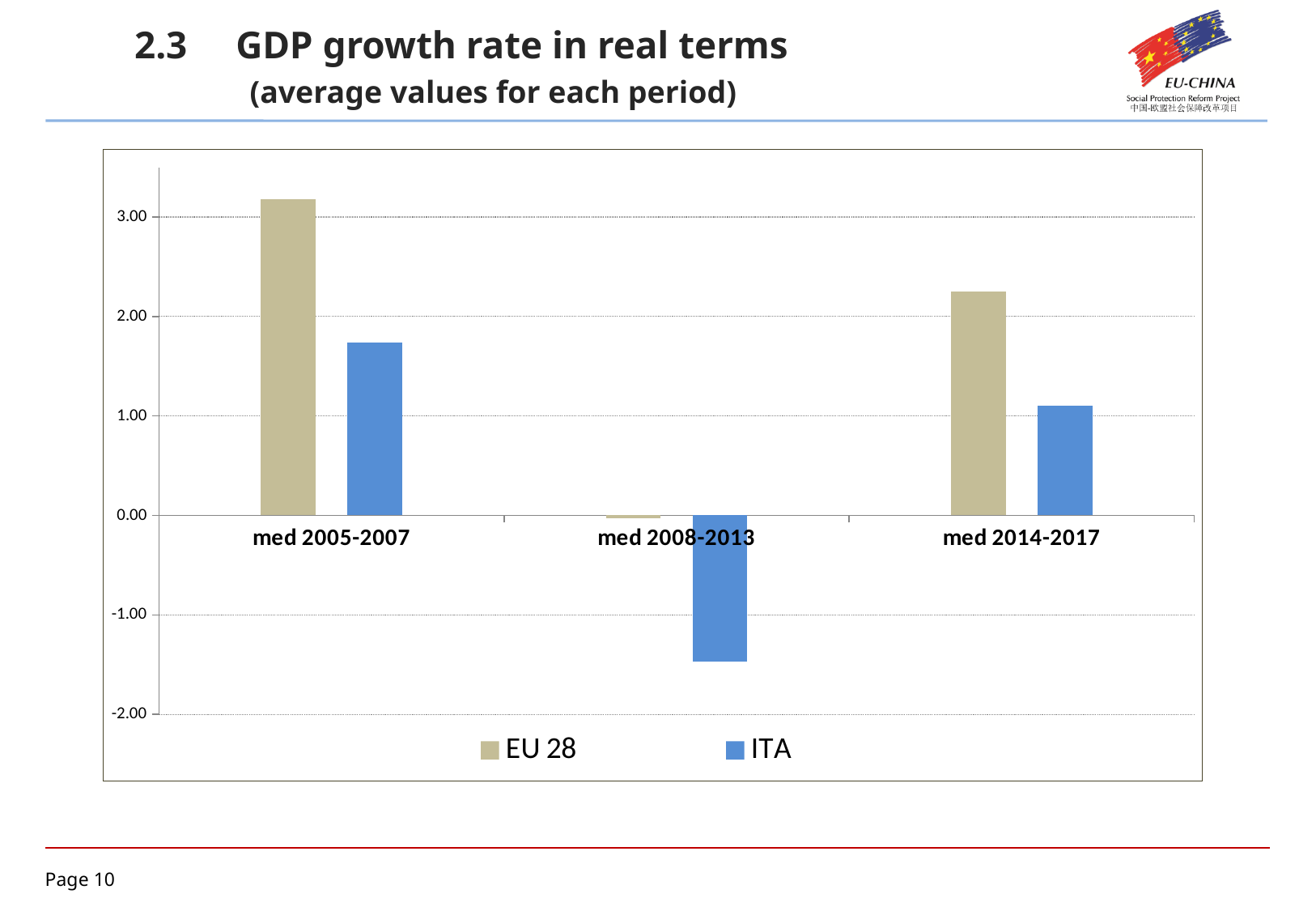
Is the ITA value for med 2014-2017 greater or less than 1.00? greater How many series does the legend list? 2 How many periods are shown on the x axis? 3 What kind of chart is shown on the slide? bar chart Which series is shown in blue in the legend? ITA Does the ITA value rise or fall from med 2005-2007 to med 2008-2013? fall In med 2005-2007, which is larger, the EU 28 value or the ITA value? EU 28 Which period has the lowest ITA value? med 2008-2013 Which period has the highest EU 28 value? med 2005-2007 Is the EU 28 value for med 2014-2017 greater or less than 2.00? greater Is the ITA value for med 2008-2013 greater or less than -1.00? less